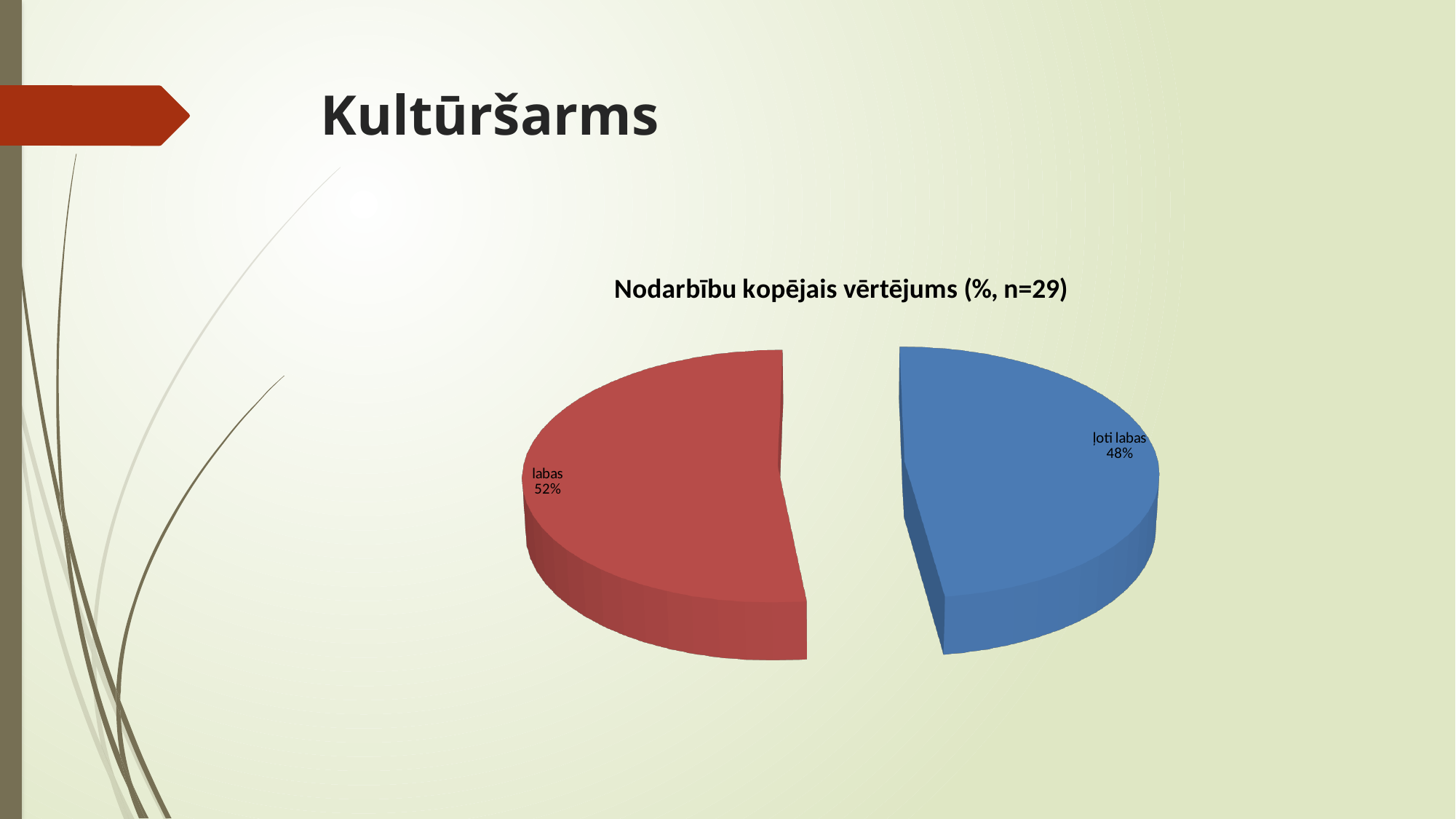
What share of the pie does the "labas" slice represent? 52% How many slices does the pie chart have? 2 What kind of chart is shown on the slide? pie chart What share of the pie does the "ļoti labas" slice represent? 48% What colour is the "ļoti labas" slice? blue Which slice is the smallest in the pie chart? ļoti labas What is the difference in percentage points between the "labas" and "ļoti labas" slices? 4 Which is larger, the "labas" slice or the "ļoti labas" slice? labas What is the title of the chart? Nodarbību kopējais vērtējums (%, n=29) Which slice is the largest in the pie chart? labas How many respondents (n) does the chart title state? 29